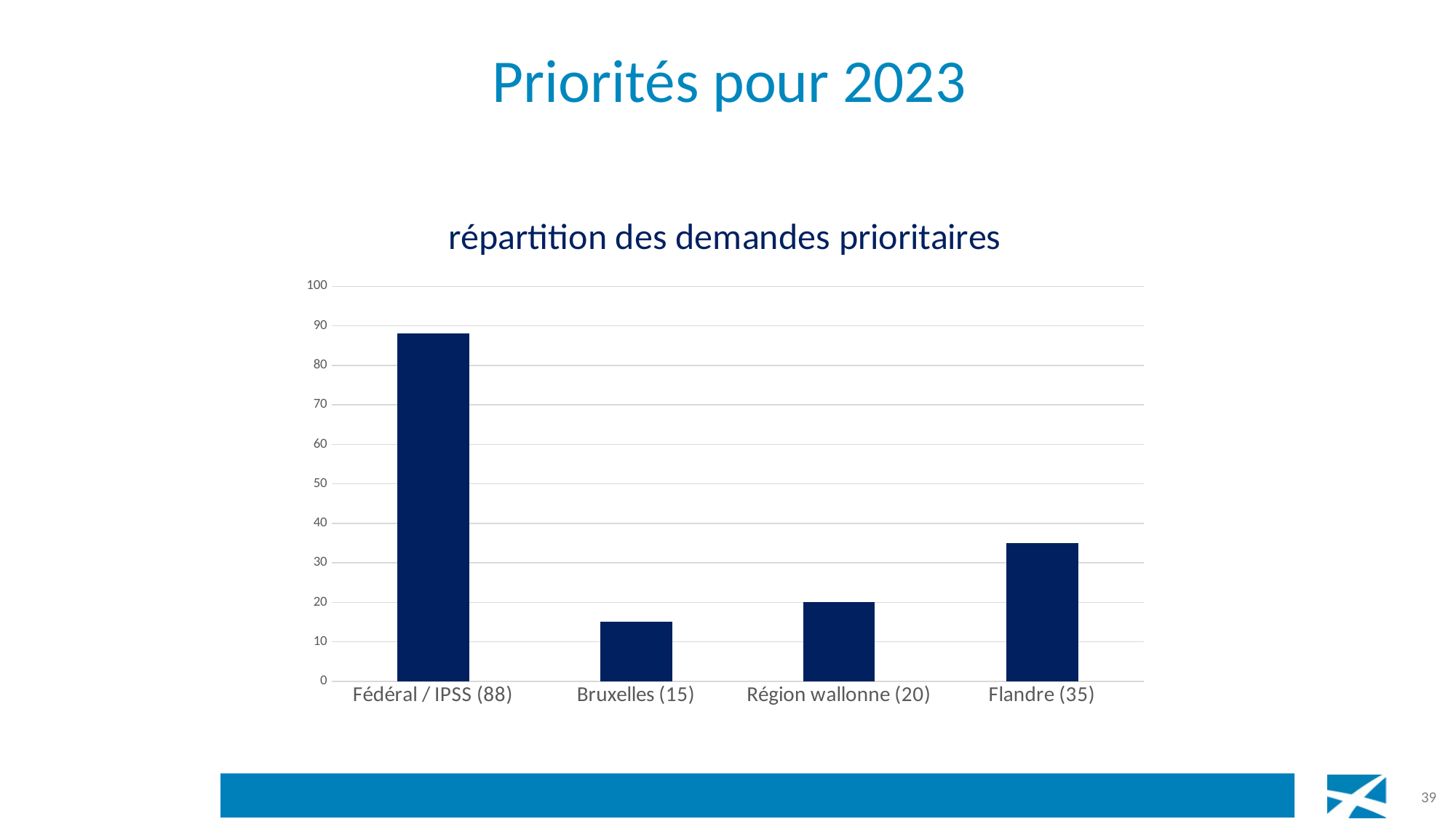
What is the difference between the values for Fédéral / IPSS and Flandre? 53 What is the value for Bruxelles? 15 What kind of chart is shown on the slide? bar chart Is the value for Flandre greater or less than 30? greater Which category has the lowest value? Bruxelles Which is larger, the value for Flandre or the value for Région wallonne? Flandre What is the value for Région wallonne? 20 Which category has the highest value? Fédéral / IPSS What is the value for Fédéral / IPSS? 88 What is the difference between the values for Région wallonne and Bruxelles? 5 What is the value for Flandre? 35 How many categories are shown in the chart? 4